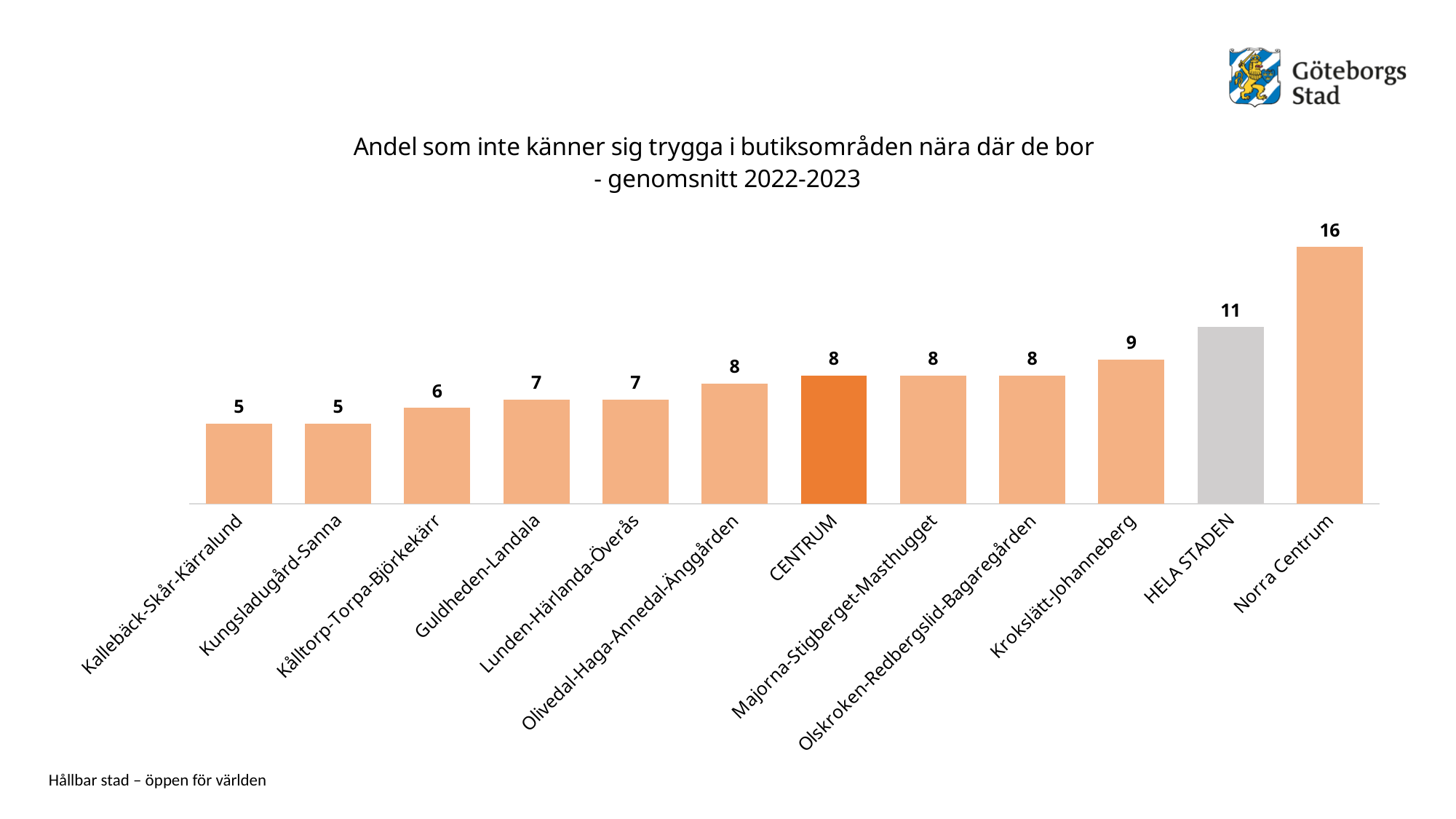
What is the difference between the values for Krokslätt-Johanneberg and Kungsladugård-Sanna? 4 What is the value for Krokslätt-Johanneberg? 9 What is the value for HELA STADEN? 11 What is the value for Norra Centrum? 16 What kind of chart is shown on the slide? Bar chart Which is larger, the value for Kålltorp-Torpa-Björkekärr or the value for Guldheden-Landala? Guldheden-Landala Do the values generally rise or fall from left to right along the x axis? Rise Which category has the highest value? Norra Centrum What is the value for CENTRUM? 8 How many categories are shown on the x axis? 12 Which bar is shown in grey rather than orange? HELA STADEN What is the difference between the values for Norra Centrum and HELA STADEN? 5